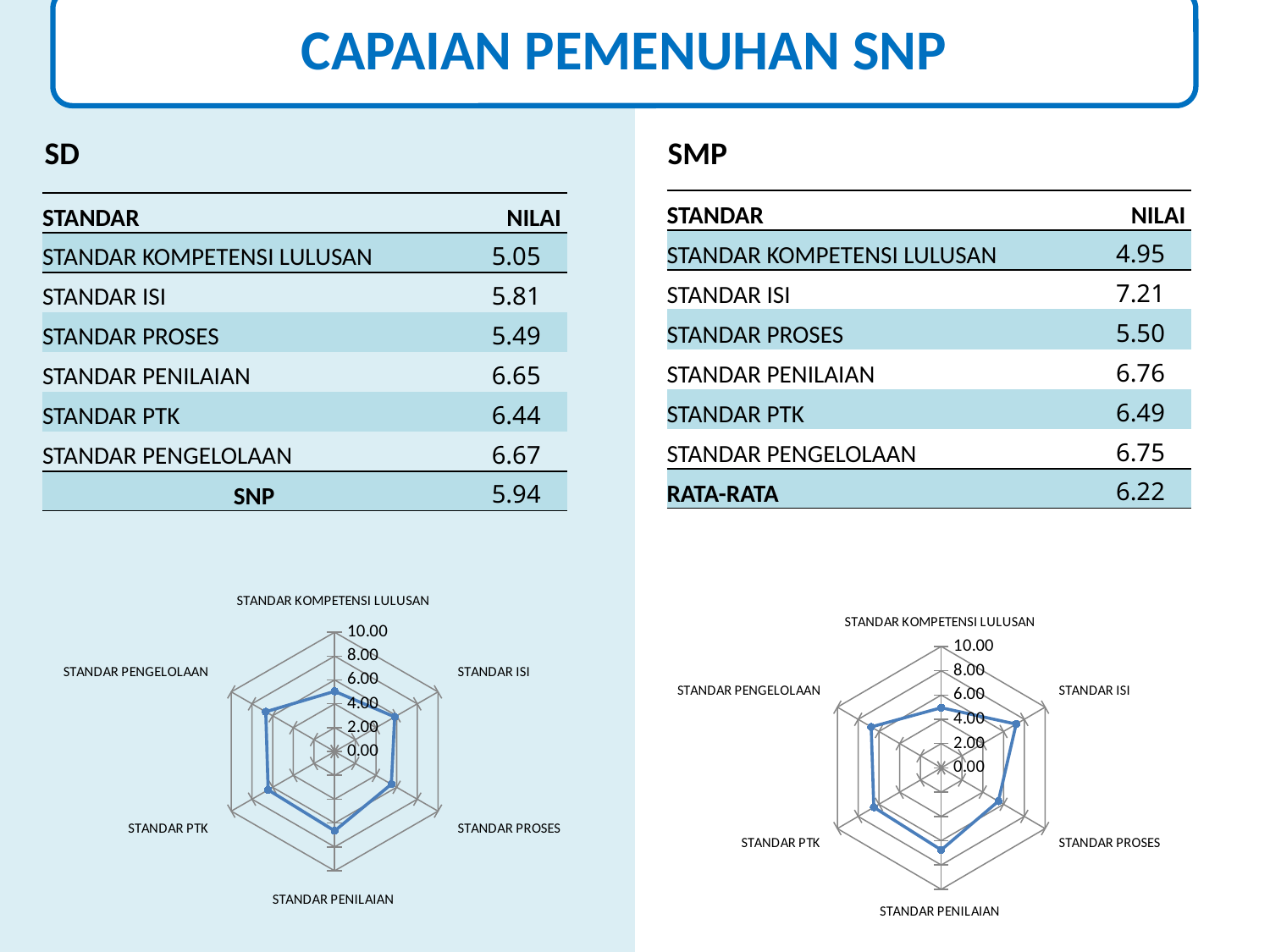
How many categories (standards) are plotted on the left SD radar chart? 6 On the left SD chart, is the value for STANDAR PENILAIAN greater or less than 6.00? greater What kind of chart is the left chart under the SD heading? radar chart On the right SMP chart, what is the value for STANDAR PTK? 6.49 On the left SD chart, what is the value for STANDAR ISI? 5.81 On the left SD chart, which is larger: STANDAR ISI or STANDAR PROSES? STANDAR ISI On the right SMP chart, which standard has the lowest value? STANDAR KOMPETENSI LULUSAN On the right SMP chart, which standard has the highest value? STANDAR ISI What is the maximum value shown on the axis scale of the right SMP radar chart? 10.00 Comparing the two charts, which has the larger value for STANDAR ISI, SD or SMP? SMP On the right SMP chart, what is the difference between STANDAR ISI and STANDAR PROSES? 1.71 On the right SMP chart, is the value for STANDAR KOMPETENSI LULUSAN greater or less than 6.00? less